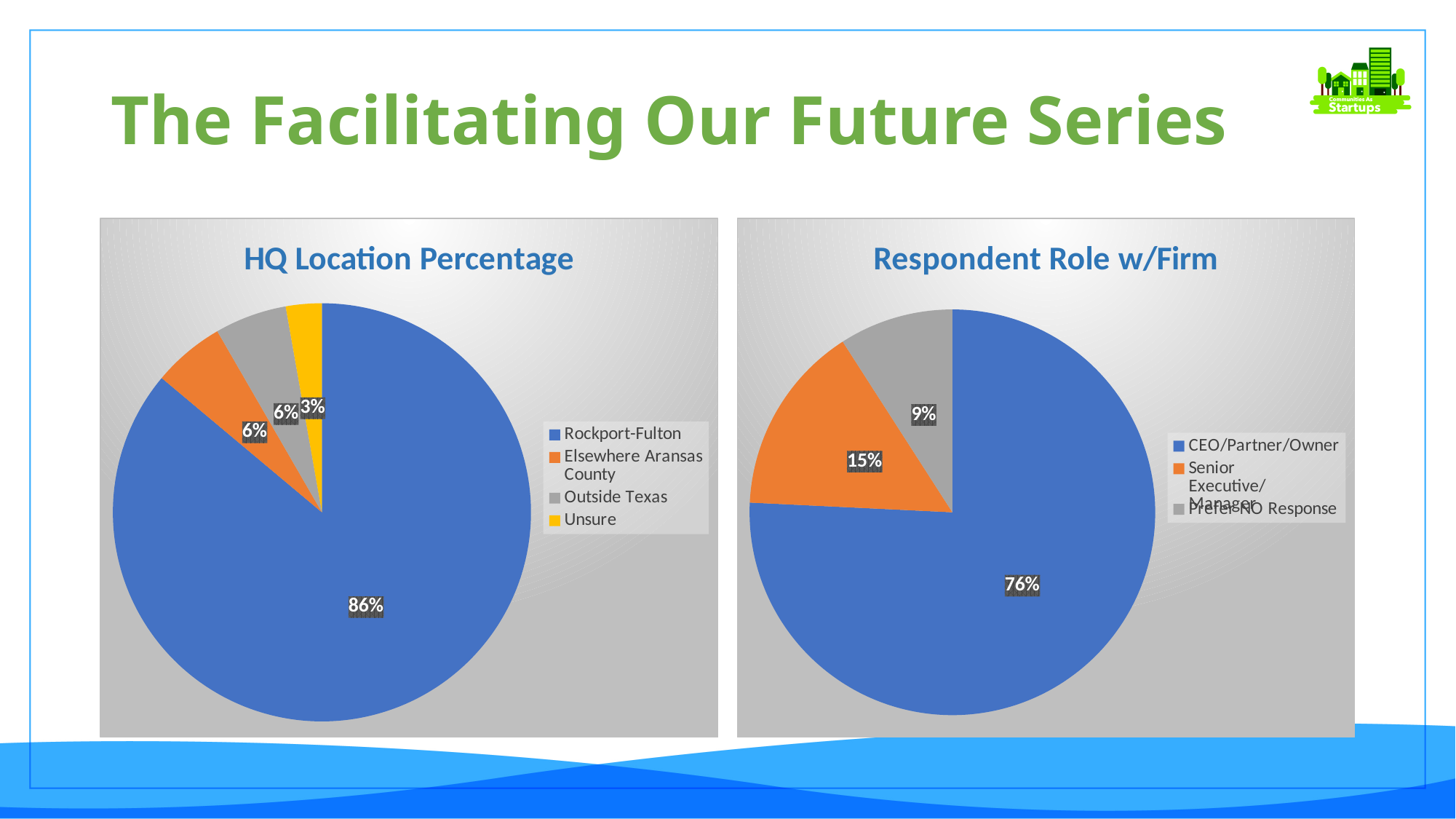
In the Respondent Role w/Firm chart, which category has the smallest share? Prefer NO Response In the HQ Location Percentage chart, which category has the largest slice? Rockport-Fulton In the HQ Location Percentage chart, what share of respondents are headquartered in Rockport-Fulton? 86% In the Respondent Role w/Firm chart, which is larger: Senior Executive/Manager or Prefer NO Response? Senior Executive/Manager In the HQ Location Percentage chart, what is the difference between the Rockport-Fulton share and the Outside Texas share? 80% In the Respondent Role w/Firm chart, what percentage is labelled Senior Executive/Manager? 15% In the Respondent Role w/Firm chart, what percentage of respondents are CEO/Partner/Owner? 76% In the HQ Location Percentage chart, what percentage is labelled Unsure? 3% In the HQ Location Percentage chart, which category has the smallest slice? Unsure In the HQ Location Percentage chart, how many categories does the legend list? 4 In the Respondent Role w/Firm chart, what colour is the CEO/Partner/Owner slice? Blue What kind of chart is the Respondent Role w/Firm chart? Pie chart